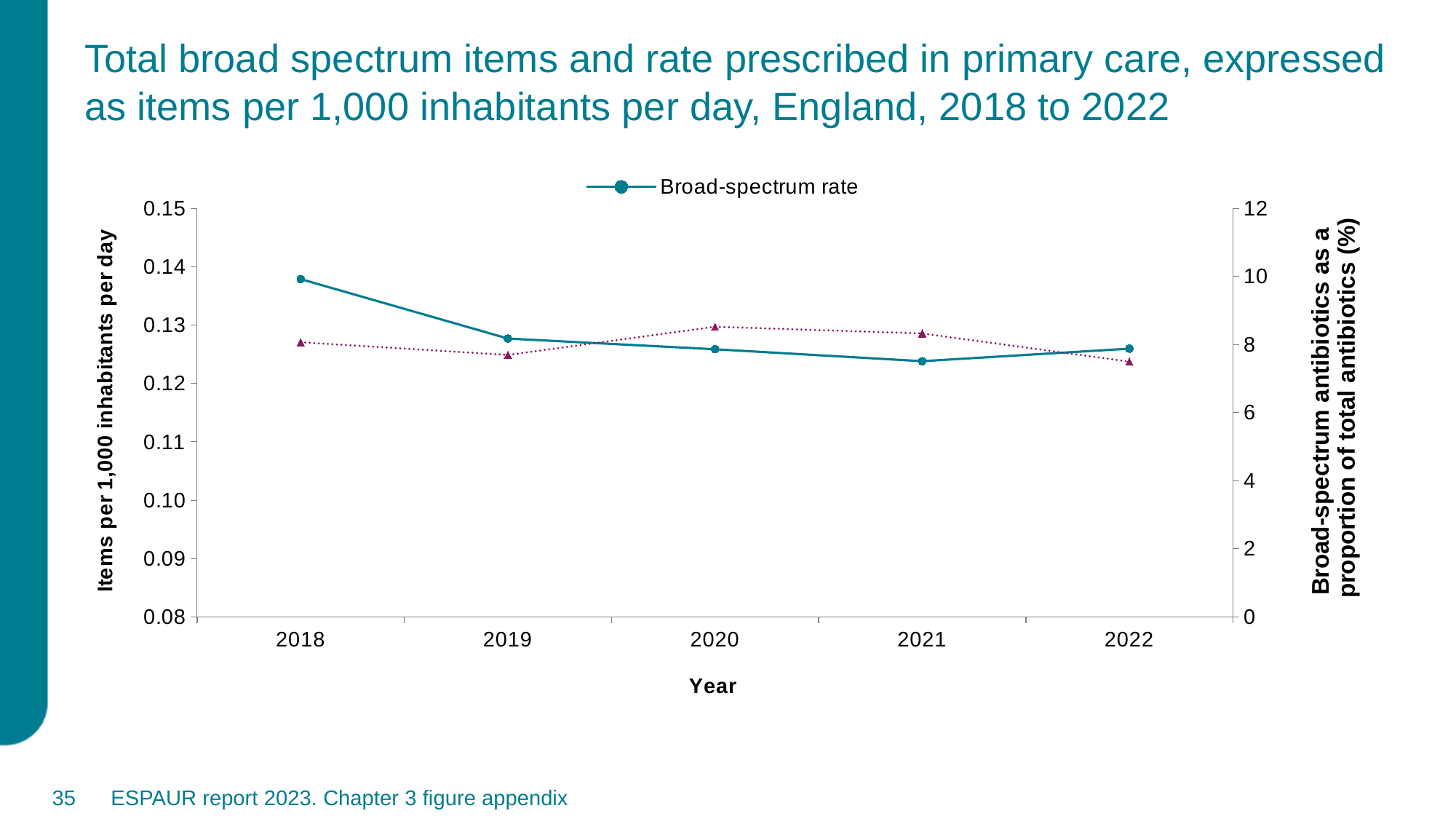
In which year is the Broad-spectrum rate highest? 2018 Which series is named in the legend? Broad-spectrum rate Does the Broad-spectrum rate rise or fall from 2018 to 2019? fall Is the Broad-spectrum rate in 2021 greater or less than 0.13 items per 1,000 inhabitants per day? less What is the title of the x axis? Year Is the Broad-spectrum rate in 2018 greater or less than 0.13 items per 1,000 inhabitants per day? greater How many years are plotted along the x axis? 5 How many series does the legend list? 1 Which year has the larger Broad-spectrum rate, 2018 or 2019? 2018 In which year is the Broad-spectrum rate lowest? 2021 What kind of chart is shown on the slide? line chart Which year has the larger Broad-spectrum rate, 2019 or 2021? 2019